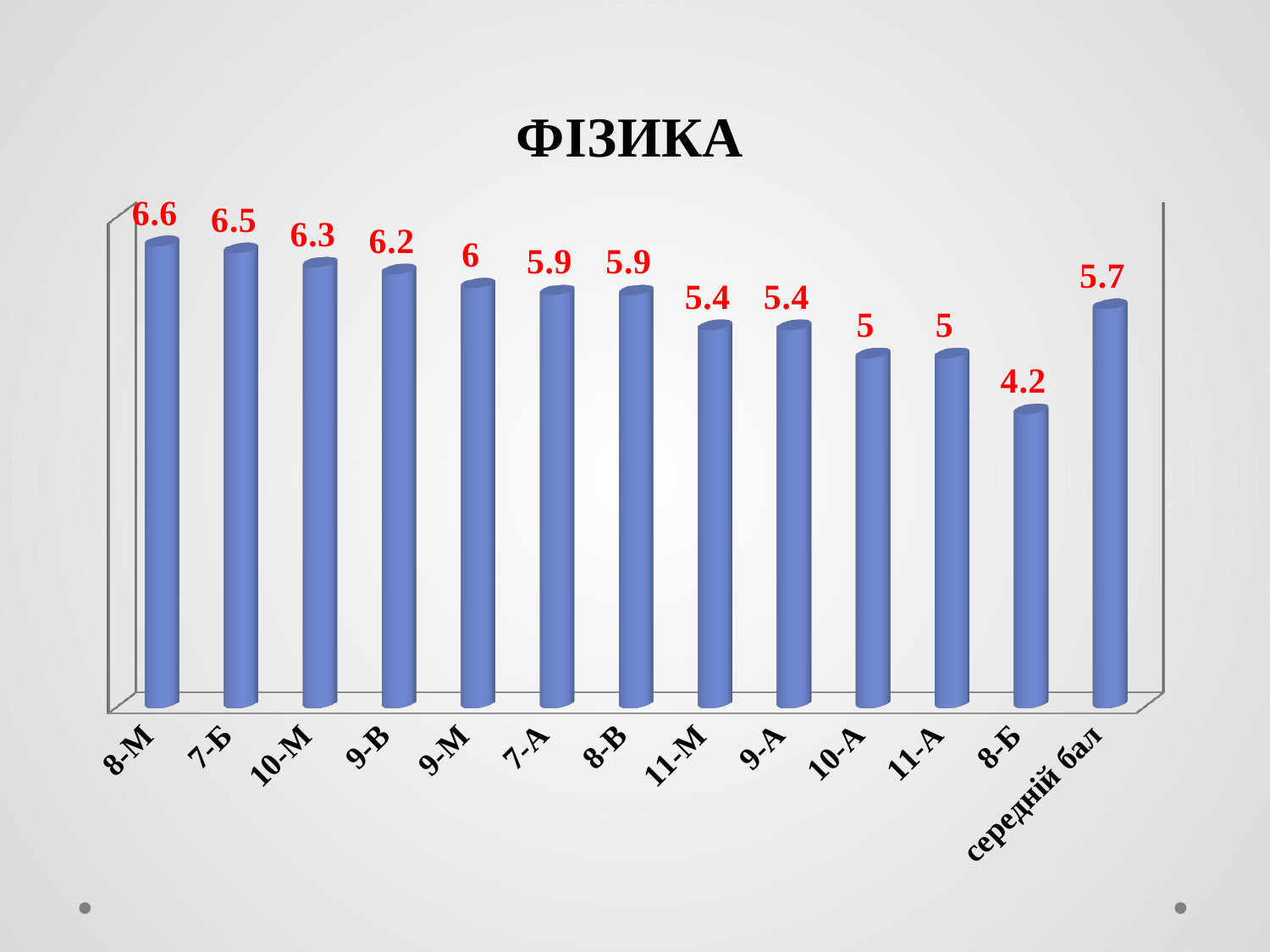
What is the value for 9-В? 6.2 Which is larger, the value for 10-М or the value for 9-А? 10-М Which category has the lowest value? 8-Б What is the title of the chart? ФІЗИКА What kind of chart is this? bar chart What is the value for 11-М? 5.4 Which category has the highest value? 8-М What is the difference between the values for 8-М and 8-Б? 2.4 How many categories are shown on the x axis? 13 What is the value for 8-М? 6.6 What is the value for середній бал? 5.7 What is the difference between the values for 7-Б and 10-А? 1.5